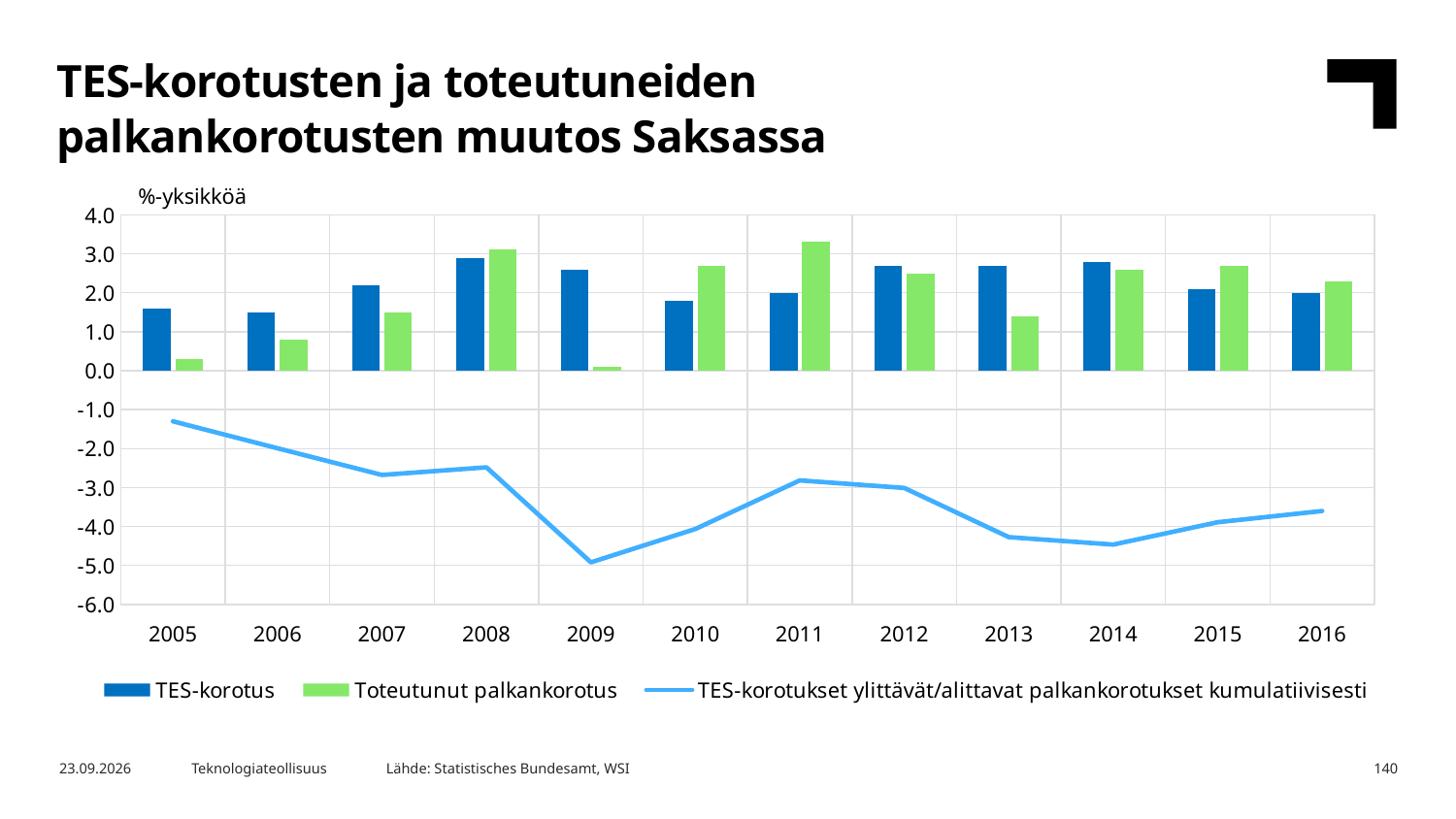
How many series does the chart legend list? 3 What kind of chart is shown on the slide? Combined bar and line chart Is the TES-korotus value for 2008 greater or less than 2.0? greater How many years are shown on the x axis of the chart? 12 Does the cumulative line rise or fall between 2008 and 2009? fall In 2011, which is larger: TES-korotus or Toteutunut palkankorotus? Toteutunut palkankorotus What unit label is shown above the vertical axis of the chart? %-yksikköä Is the cumulative line value for 2009 greater or less than -4.0? less In 2013, which is larger: TES-korotus or Toteutunut palkankorotus? TES-korotus In which year does the line 'TES-korotukset ylittävät/alittavat palkankorotukset kumulatiivisesti' reach its lowest point? 2009 Is the Toteutunut palkankorotus value for 2005 greater or less than 1.0? less In which year is the Toteutunut palkankorotus bar the lowest? 2009